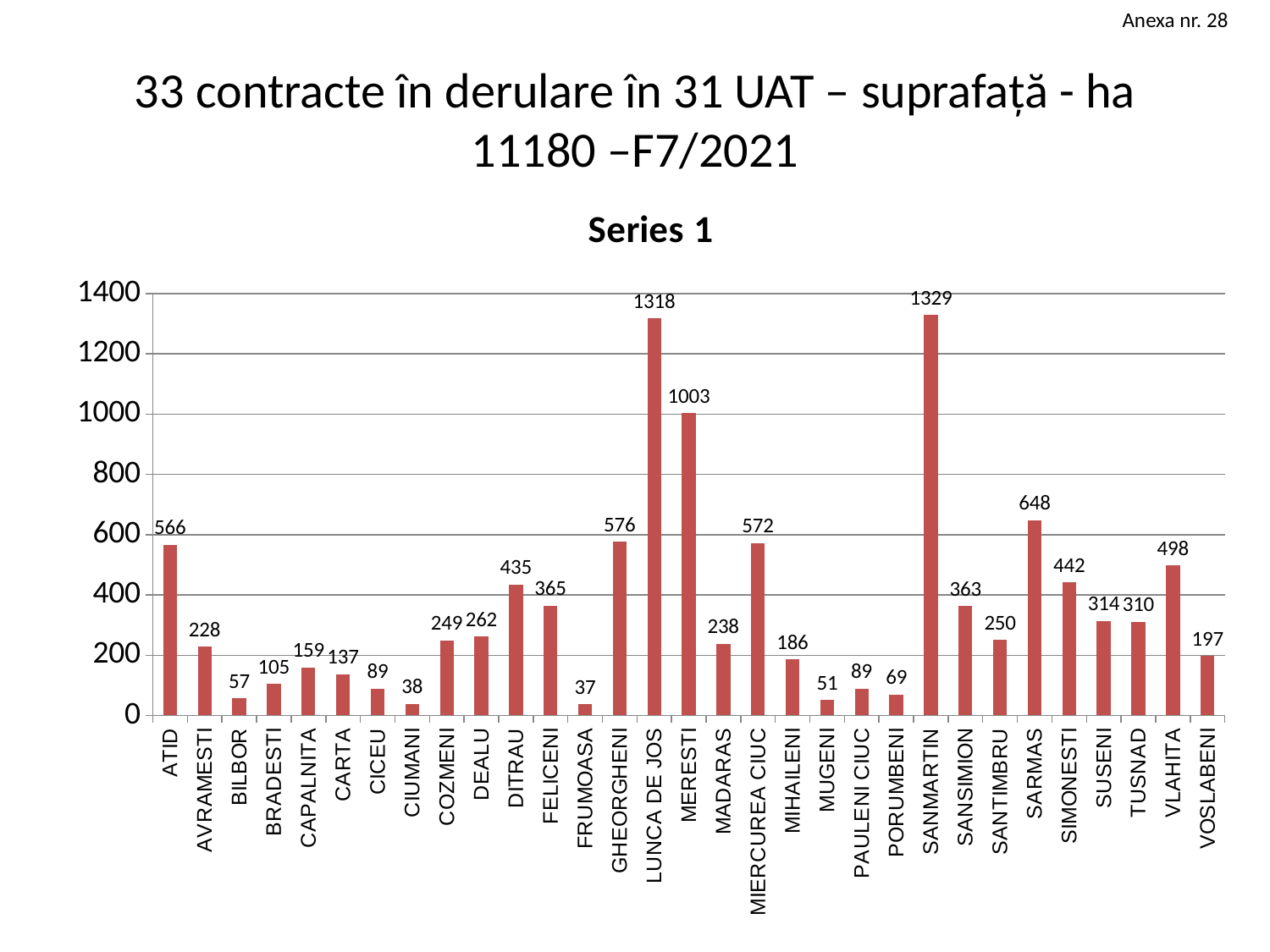
Is the value for MERESTI greater or less than 1000? greater Which is larger, the value for DITRAU or the value for FELICENI? DITRAU What is the difference between the values for GHEORGHENI and ATID? 10 Which category has the highest value? SANMARTIN What is the value for SARMAS? 648 What is the value for MIERCUREA CIUC? 572 What is the value for LUNCA DE JOS? 1318 What is the title shown above the chart? Series 1 What is the difference between the values for SANMARTIN and LUNCA DE JOS? 11 What kind of chart is shown on the slide? bar chart Which category has the lowest value? FRUMOASA How many categories are shown on the x axis? 31